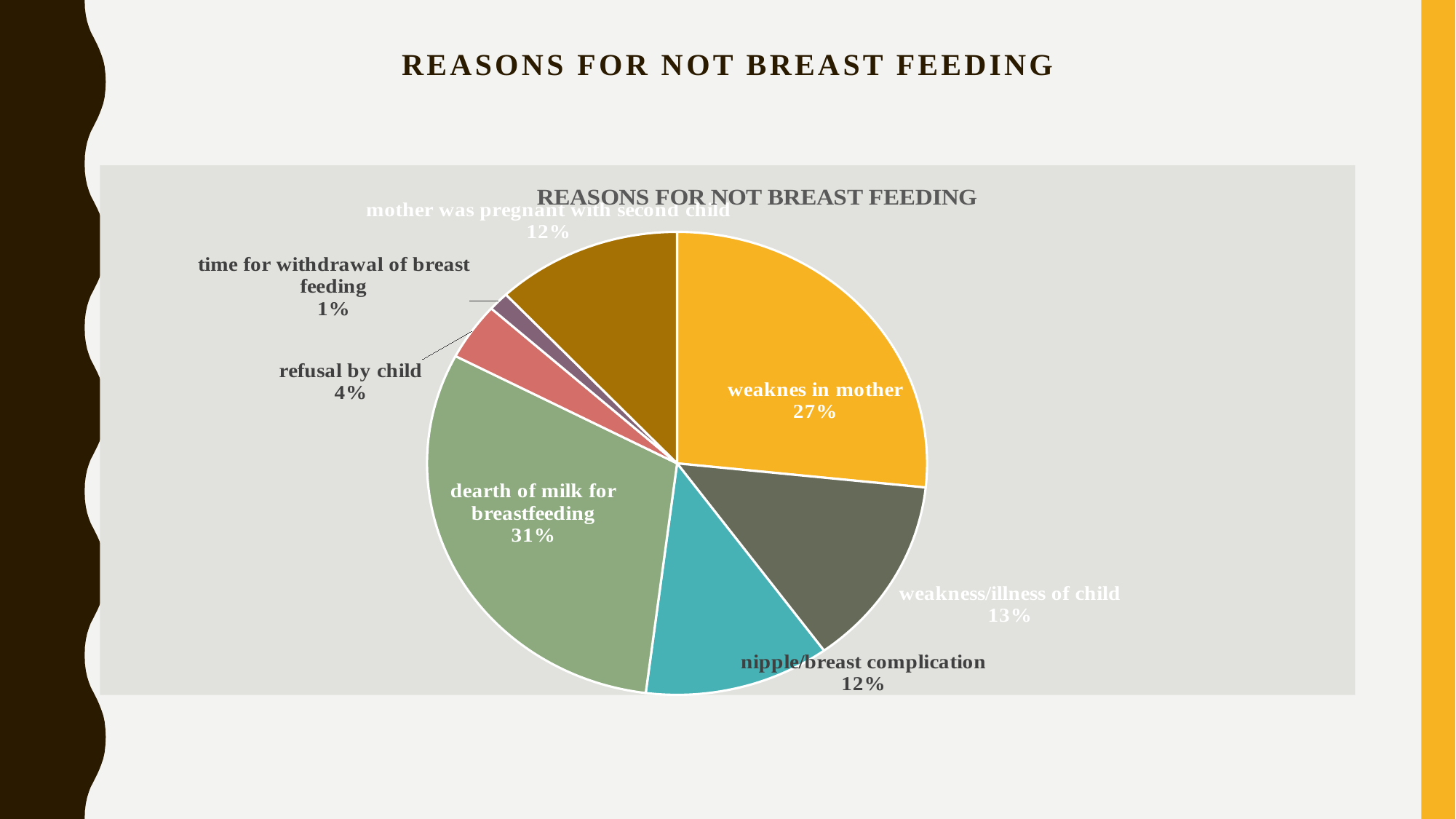
What type of chart is shown on the slide? pie chart Which reason has the smallest share of the pie? time for withdrawal of breast feeding What is the chart's title? REASONS FOR NOT BREAST FEEDING What share of the pie is 'refusal by child'? 4% What share of the pie is 'weakness/illness of child'? 13% Which reason has the largest share of the pie? dearth of milk for breastfeeding What is the difference in percentage points between 'dearth of milk for breastfeeding' and 'weaknes in mother'? 4 What share of the pie is 'dearth of milk for breastfeeding'? 31% How many slices does the pie chart have? 7